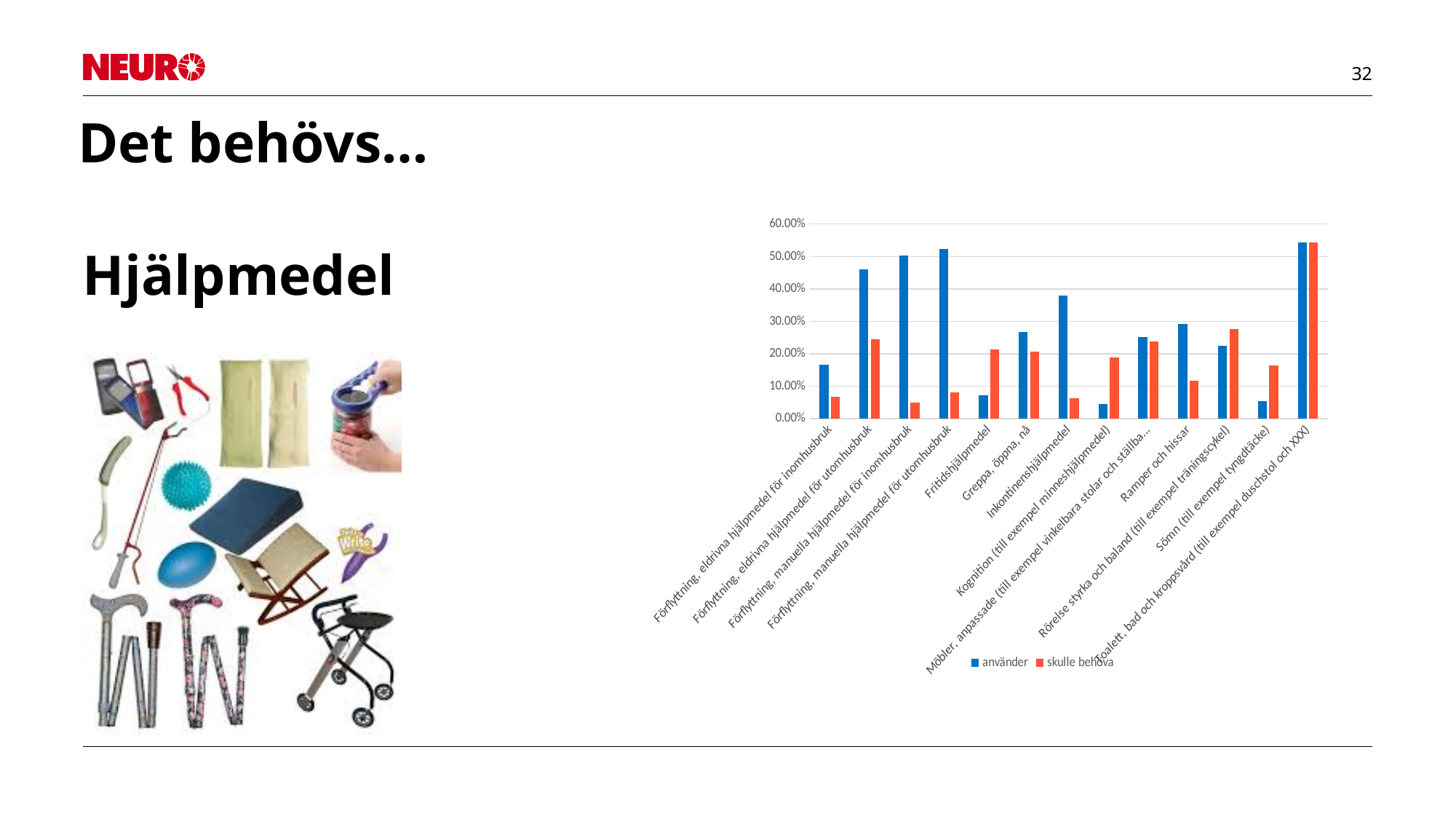
For 'Inkontinenshjälpmedel', which series has the larger value, 'använder' or 'skulle behöva'? använder What kind of chart is shown on the slide? bar chart How many series does the chart legend list? 2 For 'Fritidshjälpmedel', which series has the larger value, 'använder' or 'skulle behöva'? skulle behöva How many categories are shown along the x axis of the chart? 13 Is the 'skulle behöva' value for 'Ramper och hissar' greater or less than 20.00%? less Which category has the highest value for the 'skulle behöva' series? Toalett, bad och kroppsvård (till exempel duschstol och XXX) Is the 'använder' value for 'Kognition (till exempel minneshjälpmedel)' greater or less than 10.00%? less What are the two series named in the chart legend? använder and skulle behöva Is the 'använder' value for 'Förflyttning, manuella hjälpmedel för inomhusbruk' greater or less than 40.00%? greater Which colour represents the 'använder' series in the chart? blue